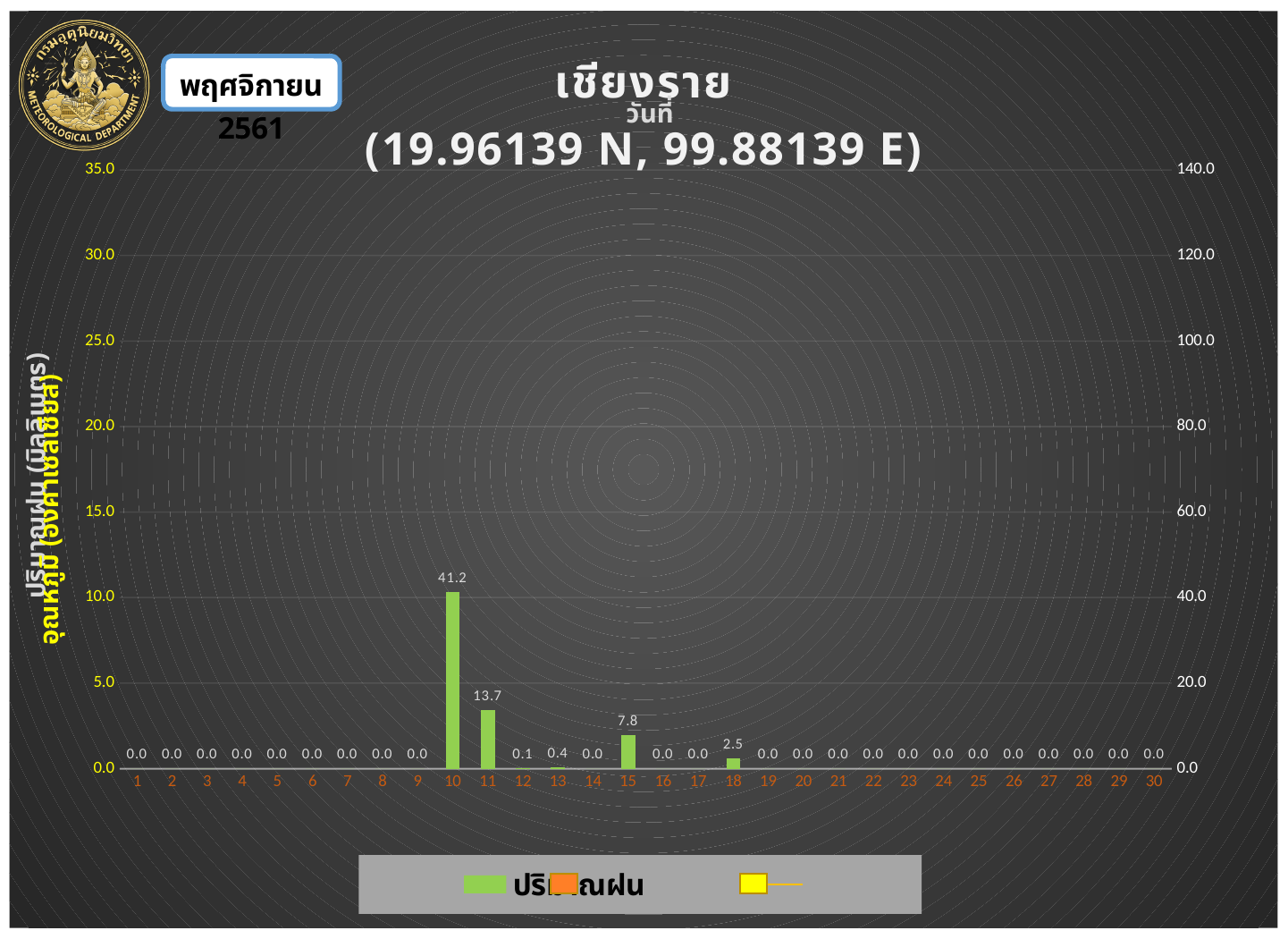
What is the difference between the rainfall values for day 10 and day 11? 27.5 Which day has the highest rainfall value? 10 What is the rainfall value shown for day 13? 0.4 What is the rainfall value shown for day 15? 7.8 How many days are shown on the x axis? 30 What is the rainfall value shown for day 18? 2.5 What is the total rainfall for days 10 and 11 combined? 54.9 What kind of chart is used to show the rainfall values? bar chart What is the rainfall value shown for day 11? 13.7 What are the coordinates shown in the chart title? 19.96139 N, 99.88139 E What is the rainfall value shown for day 10? 41.2 Which is larger, the rainfall value for day 15 or for day 18? day 15